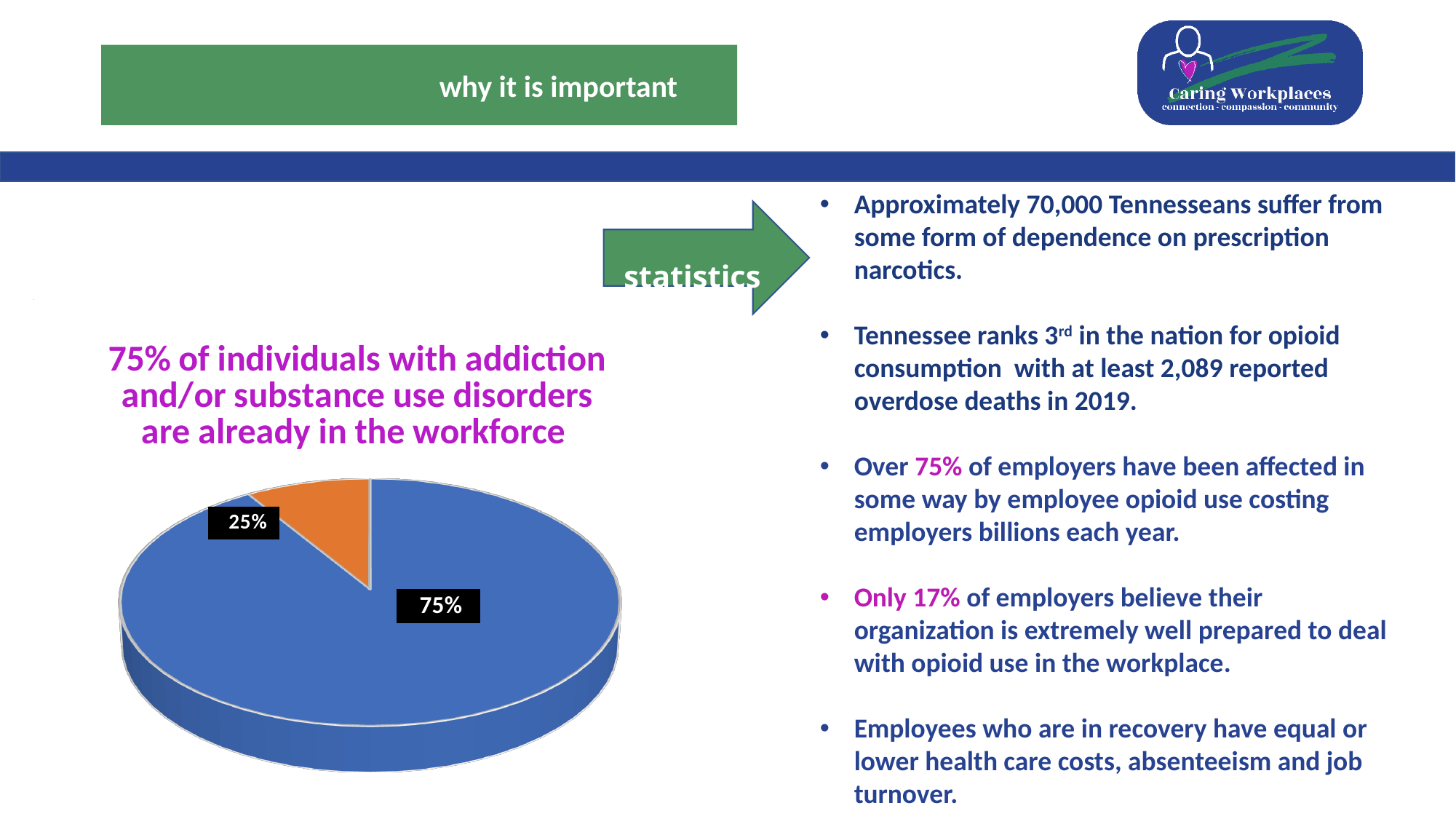
What do the two slice percentages in the pie chart add up to? 100% Which is larger, the blue slice or the orange slice? the blue slice Which slice of the pie chart is the largest? the blue slice (75%) What share of the pie does the blue slice represent? 75% What share of the pie does the orange slice represent? 25% How many slices does the pie chart have? 2 Which slice of the pie chart is the smallest? the orange slice (25%) What statement appears above the pie chart describing what the 75% slice represents? 75% of individuals with addiction and/or substance use disorders are already in the workforce What colour is the slice labelled 75%? blue What kind of chart is shown on the slide? pie chart What is the difference in percentage points between the blue slice and the orange slice? 50 Is the share of the orange slice greater or less than 50%? less